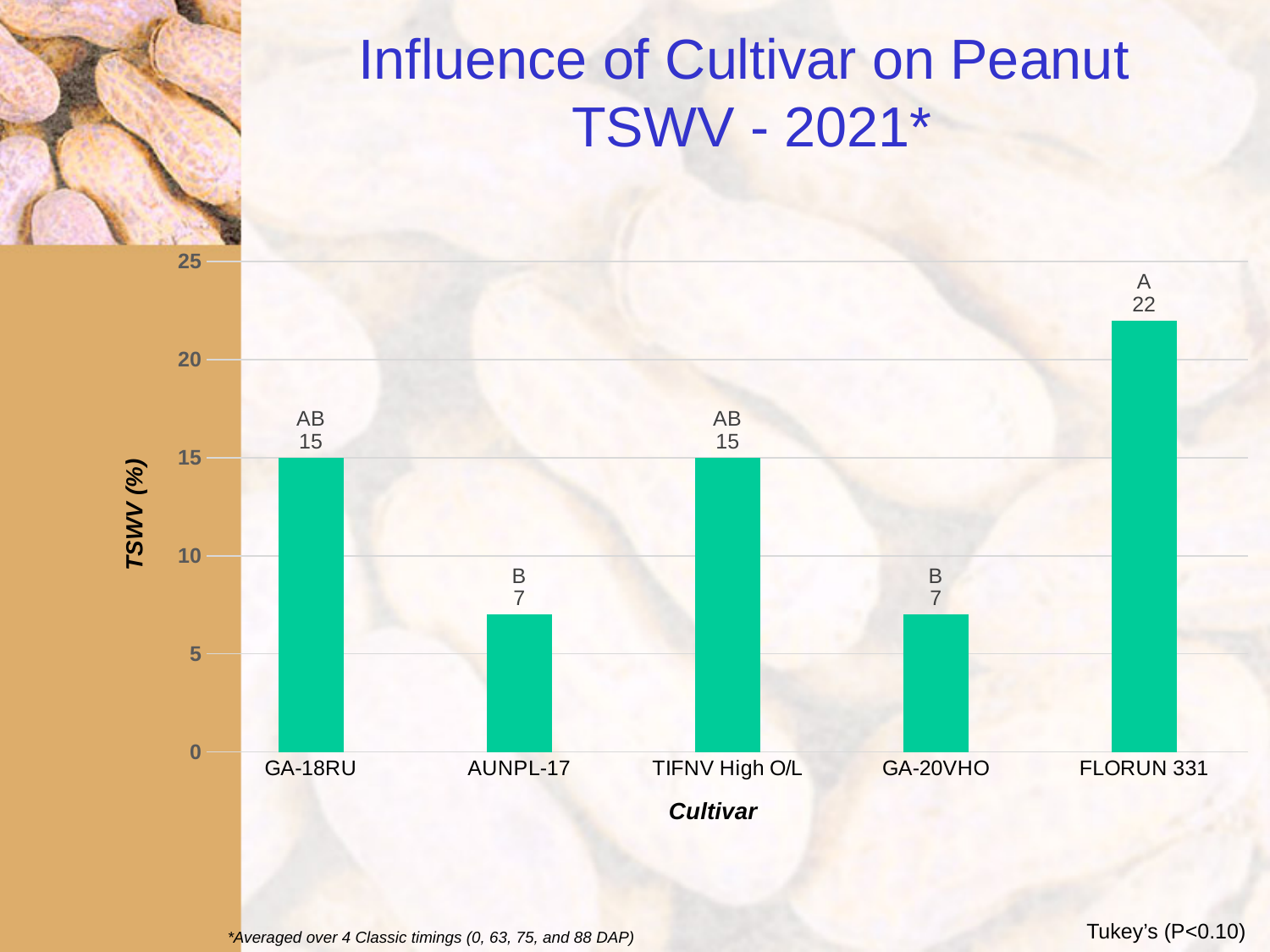
Is the value for FLORUN 331 greater or less than 20? greater What is the difference in TSWV (%) between GA-18RU and AUNPL-17? 8 Which has a higher TSWV (%), TIFNV High O/L or GA-20VHO? TIFNV High O/L What is the difference in TSWV (%) between FLORUN 331 and GA-20VHO? 15 What is the TSWV (%) value for FLORUN 331? 22 What is the title of the chart? Influence of Cultivar on Peanut TSWV - 2021* How many cultivars are shown on the x axis? 5 What is the TSWV (%) value for GA-18RU? 15 What kind of chart is shown on the slide? bar chart Which cultivar has the highest TSWV (%)? FLORUN 331 What statistical grouping letter is shown above the FLORUN 331 bar? A What is the TSWV (%) value for AUNPL-17? 7